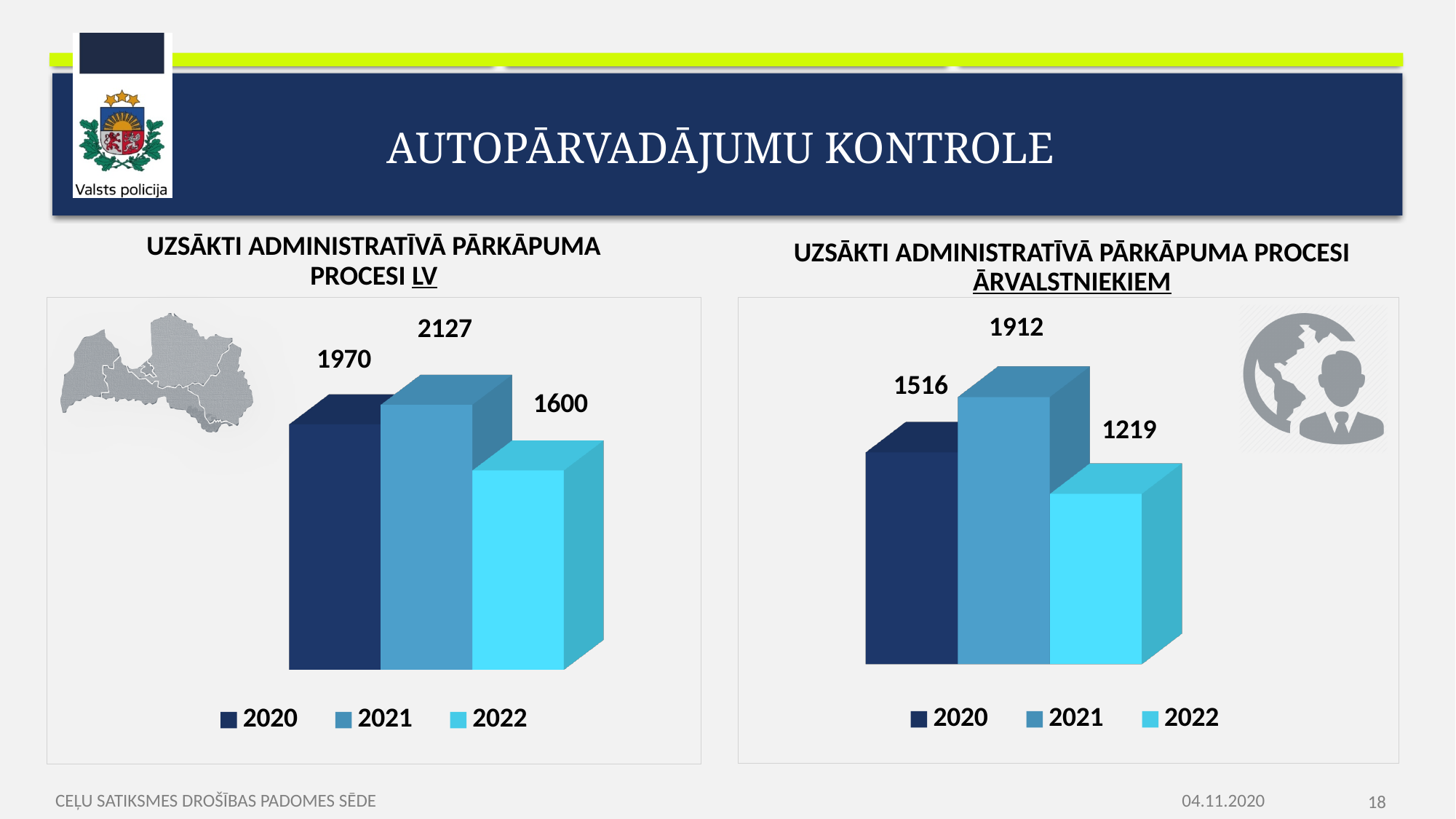
In the left chart (UZSĀKTI ADMINISTRATĪVĀ PĀRKĀPUMA PROCESI LV), what is the difference between the 2021 and 2022 values? 527 In the right chart (UZSĀKTI ADMINISTRATĪVĀ PĀRKĀPUMA PROCESI ĀRVALSTNIEKIEM), what is the value for 2022? 1219 In the right chart (UZSĀKTI ADMINISTRATĪVĀ PĀRKĀPUMA PROCESI ĀRVALSTNIEKIEM), what is the value for 2020? 1516 What kind of chart is the right chart (UZSĀKTI ADMINISTRATĪVĀ PĀRKĀPUMA PROCESI ĀRVALSTNIEKIEM)? Bar chart How many series does the legend of the left chart (UZSĀKTI ADMINISTRATĪVĀ PĀRKĀPUMA PROCESI LV) list? 3 In the right chart (UZSĀKTI ADMINISTRATĪVĀ PĀRKĀPUMA PROCESI ĀRVALSTNIEKIEM), which year has the lowest value? 2022 In the left chart (UZSĀKTI ADMINISTRATĪVĀ PĀRKĀPUMA PROCESI LV), which colour represents 2022 in the legend? Light blue (cyan) In the left chart (UZSĀKTI ADMINISTRATĪVĀ PĀRKĀPUMA PROCESI LV), which year has the highest value? 2021 In the left chart (UZSĀKTI ADMINISTRATĪVĀ PĀRKĀPUMA PROCESI LV), what is the value for 2022? 1600 In the right chart (UZSĀKTI ADMINISTRATĪVĀ PĀRKĀPUMA PROCESI ĀRVALSTNIEKIEM), which is larger, the value for 2020 or the value for 2022? 2020 In the left chart (UZSĀKTI ADMINISTRATĪVĀ PĀRKĀPUMA PROCESI LV), what is the value for 2021? 2127 In the right chart (UZSĀKTI ADMINISTRATĪVĀ PĀRKĀPUMA PROCESI ĀRVALSTNIEKIEM), what is the difference between the 2021 and 2020 values? 396